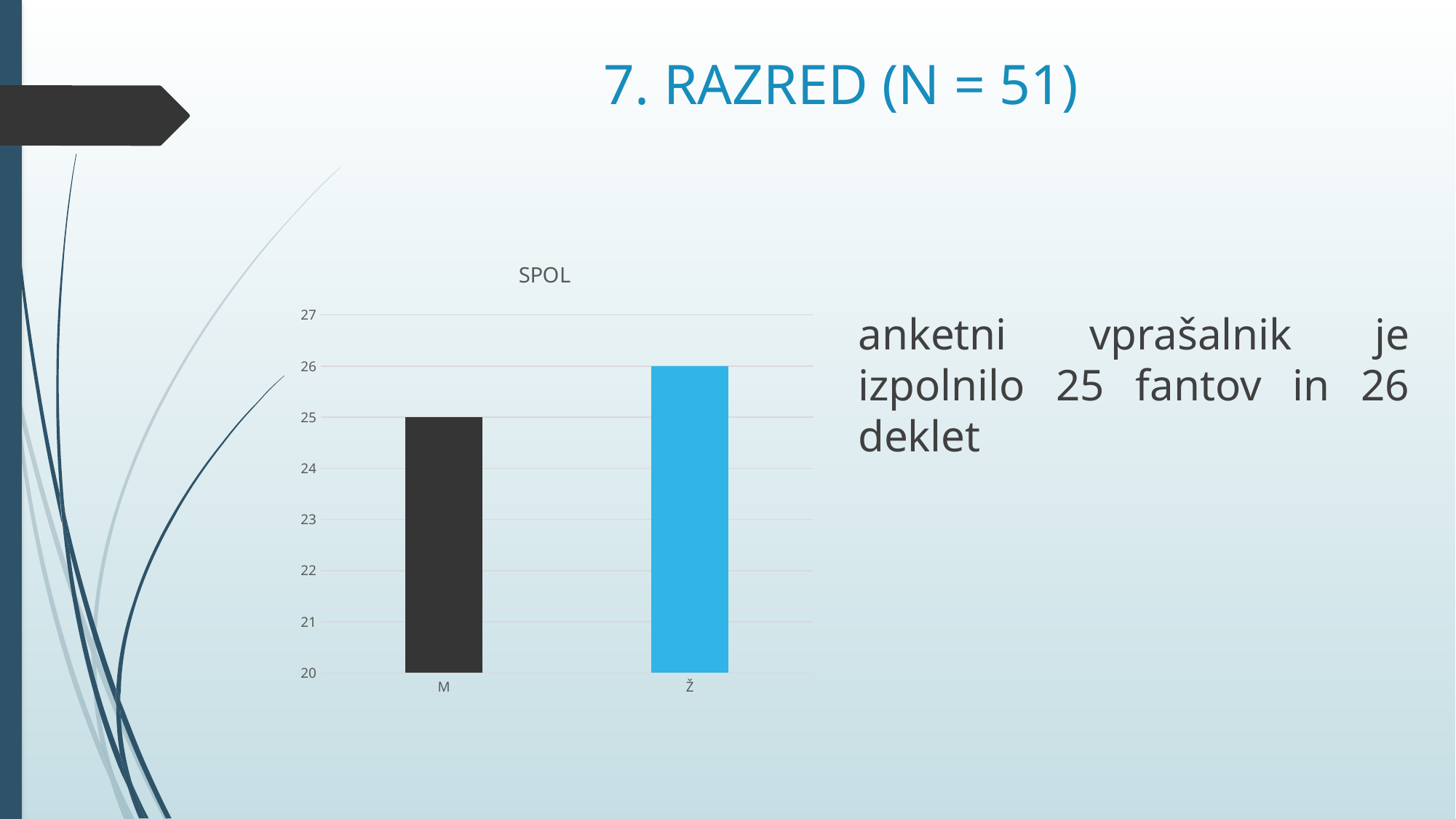
What is the title of the chart on the slide? SPOL Is the value for Ž in the SPOL chart greater or less than 27? less How many categories are shown in the SPOL chart? 2 Which category has the lowest value in the SPOL chart? M Which category has the highest value in the SPOL chart? Ž What is the value for Ž in the SPOL chart? 26 What kind of chart is the SPOL chart? bar chart Is the value for M in the SPOL chart greater or less than 24? greater Which is larger in the SPOL chart, the value for M or the value for Ž? Ž Do the values rise or fall from M to Ž in the SPOL chart? rise What is the value for M in the SPOL chart? 25 What is the difference between the values for Ž and M in the SPOL chart? 1